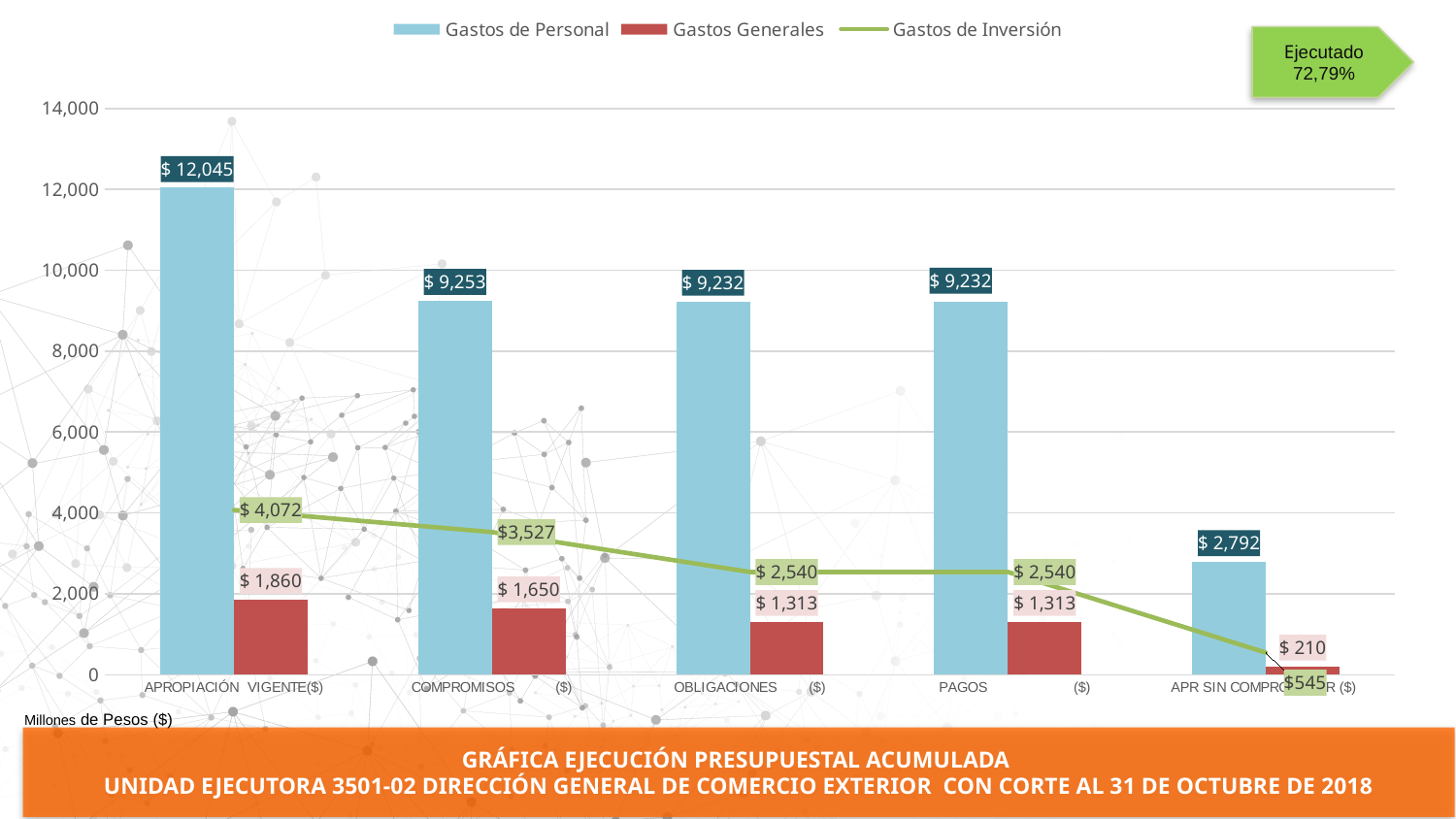
Which category has the lowest value for Gastos Generales? The rightmost category (APR SIN COMPROMETER) What percentage is shown in the green 'Ejecutado' arrow? 72,79% Which is larger: Gastos de Inversión for COMPROMISOS or Gastos Generales for COMPROMISOS? Gastos de Inversión for COMPROMISOS Which category has the highest value for Gastos de Personal? APROPIACIÓN VIGENTE How many series does the legend list? 3 How many categories are shown on the x axis? 5 Does the Gastos de Inversión line rise or fall from left to right across the categories? Fall What is the value of Gastos de Personal for COMPROMISOS? $ 9,253 What is the value of Gastos Generales for APROPIACIÓN VIGENTE? $ 1,860 What is the value of Gastos de Inversión for OBLIGACIONES? $ 2,540 What is the value of Gastos de Inversión for the rightmost category? $ 545 What is the difference between Gastos de Personal for APROPIACIÓN VIGENTE and for COMPROMISOS? $ 2,792